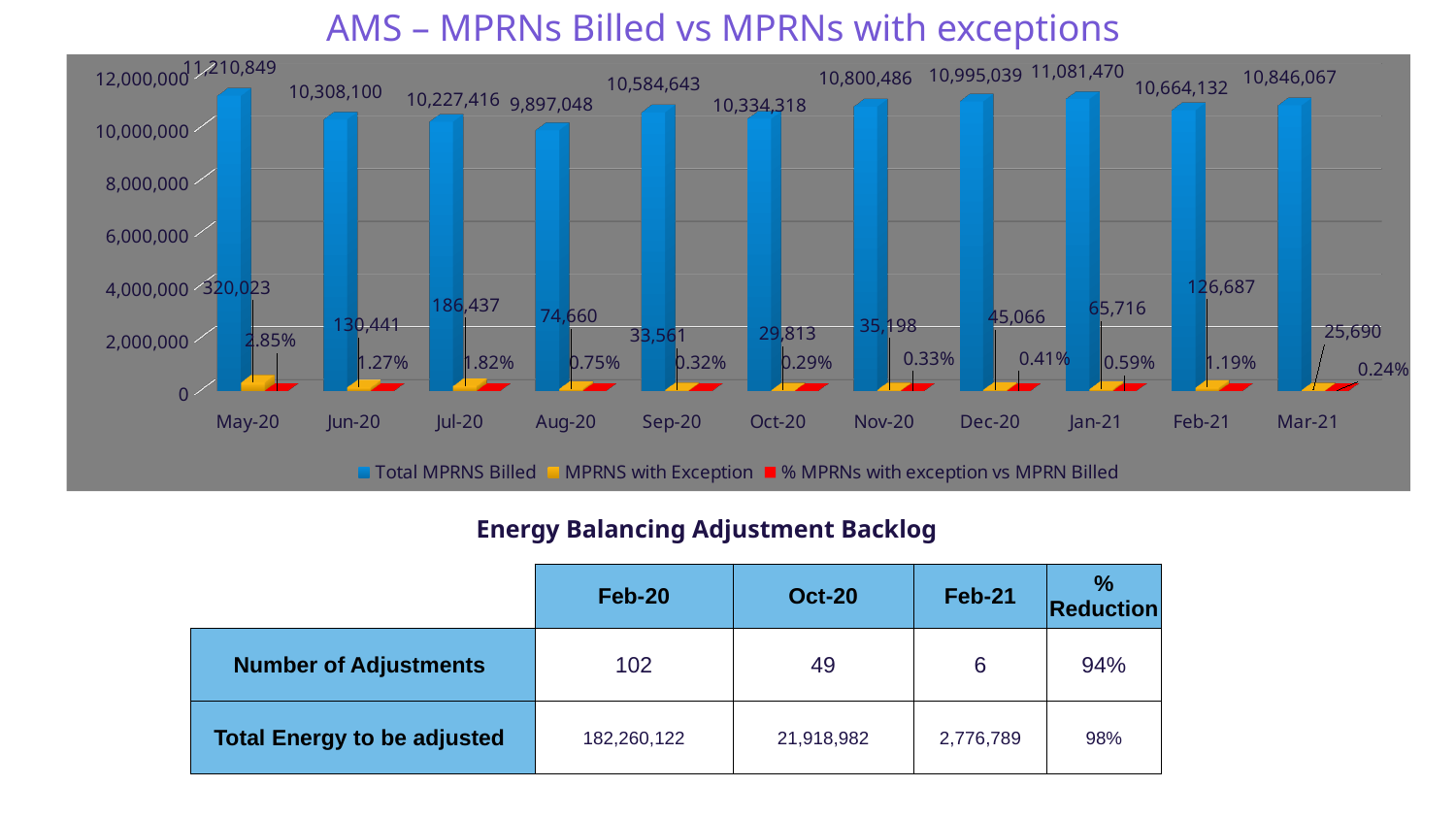
Which is larger, the MPRNS with Exception value for Jul-20 or for Jun-20? Jul-20 Which month has the lowest MPRNS with Exception value? Mar-21 What is the difference between Total MPRNS Billed in May-20 and Jun-20? 902,749 How many series does the chart legend list? 3 What kind of chart is shown on the slide? Bar chart What is the difference between MPRNS with Exception in Feb-21 and Jan-21? 60,971 What is the Total MPRNS Billed value for Aug-20? 9,897,048 Which month has the highest Total MPRNS Billed? May-20 Which month has the lowest Total MPRNS Billed? Aug-20 What is the MPRNS with Exception value for Feb-21? 126,687 How many months are shown on the x axis of the chart? 11 What is the % MPRNs with exception vs MPRN Billed for Oct-20? 0.29%